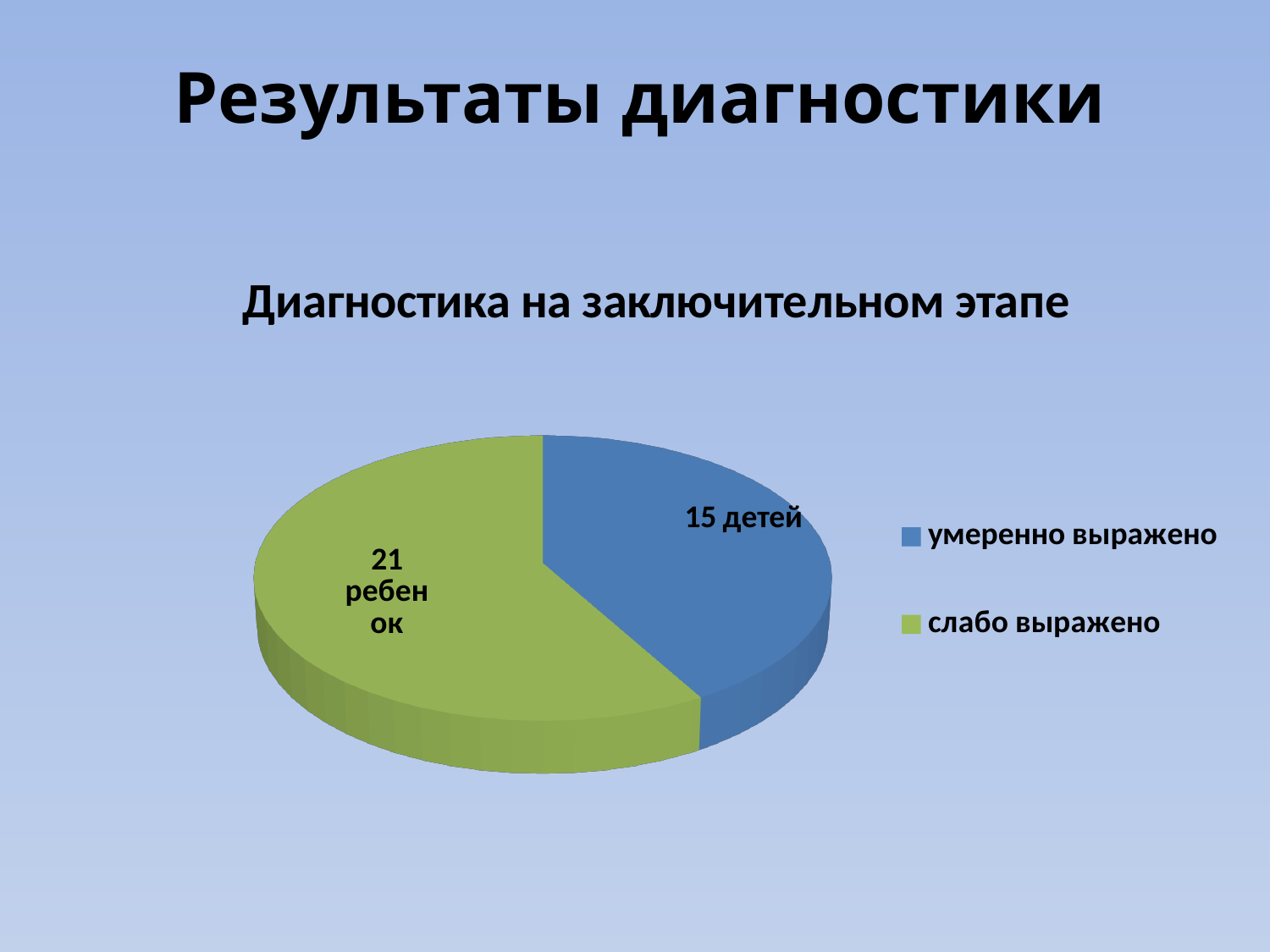
What is the difference between the number of children in 'слабо выражено' and 'умеренно выражено'? 6 How many slices does the pie chart have? 2 Which is larger: 'умеренно выражено' or 'слабо выражено'? слабо выражено How many children are in the 'слабо выражено' slice? 21 ребенок What is the total number of children represented in the pie chart? 36 What is the title of the chart? Диагностика на заключительном этапе What colour is the 'слабо выражено' slice? green How many children are in the 'умеренно выражено' slice? 15 детей Which category has the smallest slice of the pie? умеренно выражено What type of chart is shown on the slide? pie chart Which category has the largest slice of the pie? слабо выражено How many entries does the legend list? 2